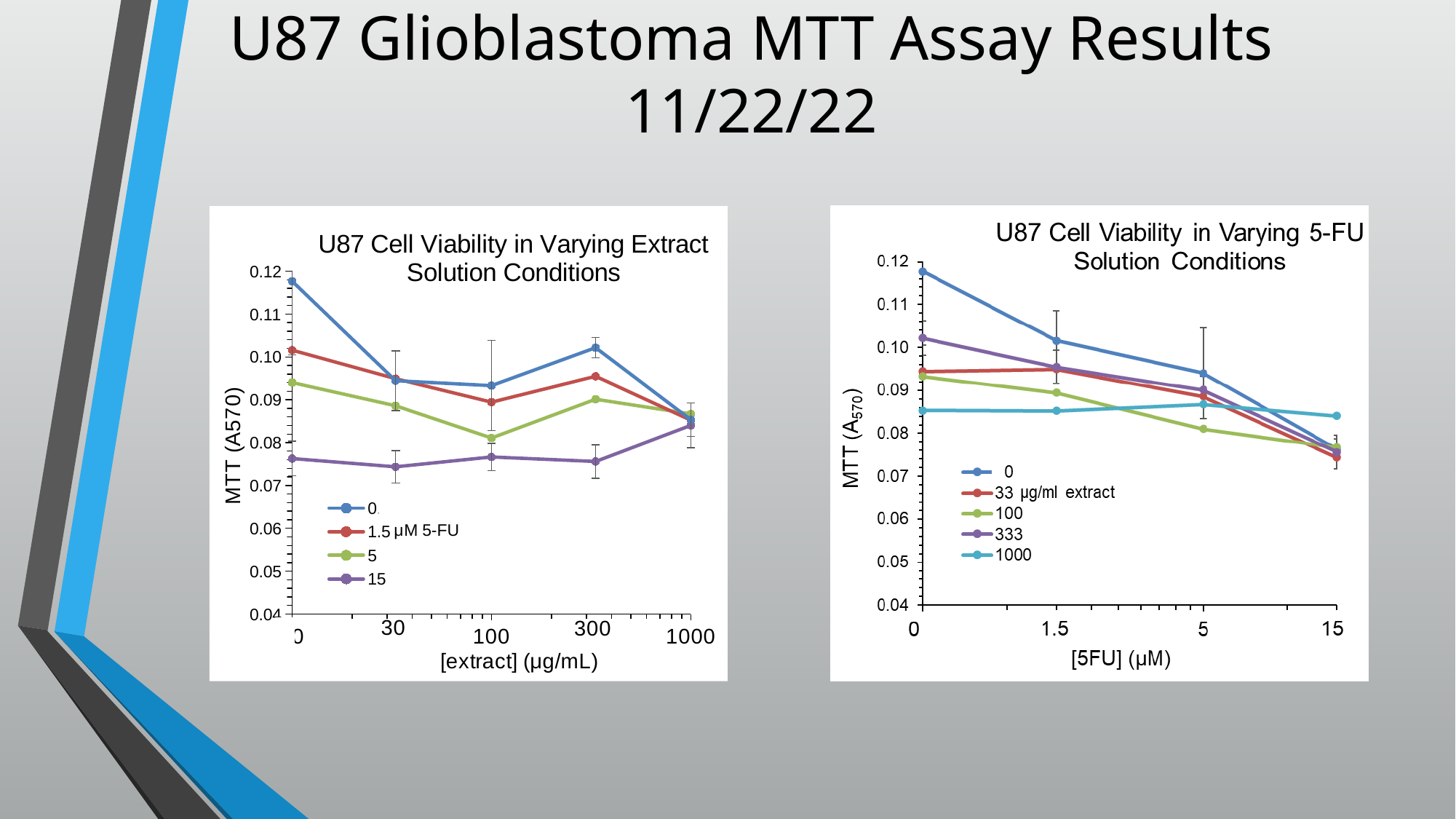
In the chart titled "U87 Cell Viability in Varying Extract Solution Conditions", what kind of chart is shown? line chart In the chart titled "U87 Cell Viability in Varying 5-FU Solution Conditions", at 5FU concentration 0, which series has the higher value: "0" or "1000"? 0 In the chart titled "U87 Cell Viability in Varying Extract Solution Conditions", is the value of the "0" series at extract concentration 0 greater or less than 0.11? greater In the chart titled "U87 Cell Viability in Varying Extract Solution Conditions", is the value of the "15" series at extract concentration 30 greater or less than 0.08? less In the chart titled "U87 Cell Viability in Varying 5-FU Solution Conditions", does the "0" series rise or fall as 5FU concentration increases from 0 to 15? fall In the chart titled "U87 Cell Viability in Varying Extract Solution Conditions", how many extract concentrations are plotted along the x axis? 5 In the chart titled "U87 Cell Viability in Varying 5-FU Solution Conditions", is the value of the "1000" series at 5FU concentration 0 greater or less than 0.09? less In the chart titled "U87 Cell Viability in Varying 5-FU Solution Conditions", how many series does the legend list? 5 In the chart titled "U87 Cell Viability in Varying 5-FU Solution Conditions", how many 5FU concentrations are plotted along the x axis? 4 In the chart titled "U87 Cell Viability in Varying Extract Solution Conditions", at extract concentration 0, which series has the higher value: "0" or "15"? 0 In the chart titled "U87 Cell Viability in Varying 5-FU Solution Conditions", what is the x-axis label? [5FU] (µM) In the chart titled "U87 Cell Viability in Varying Extract Solution Conditions", how many series does the legend list? 4